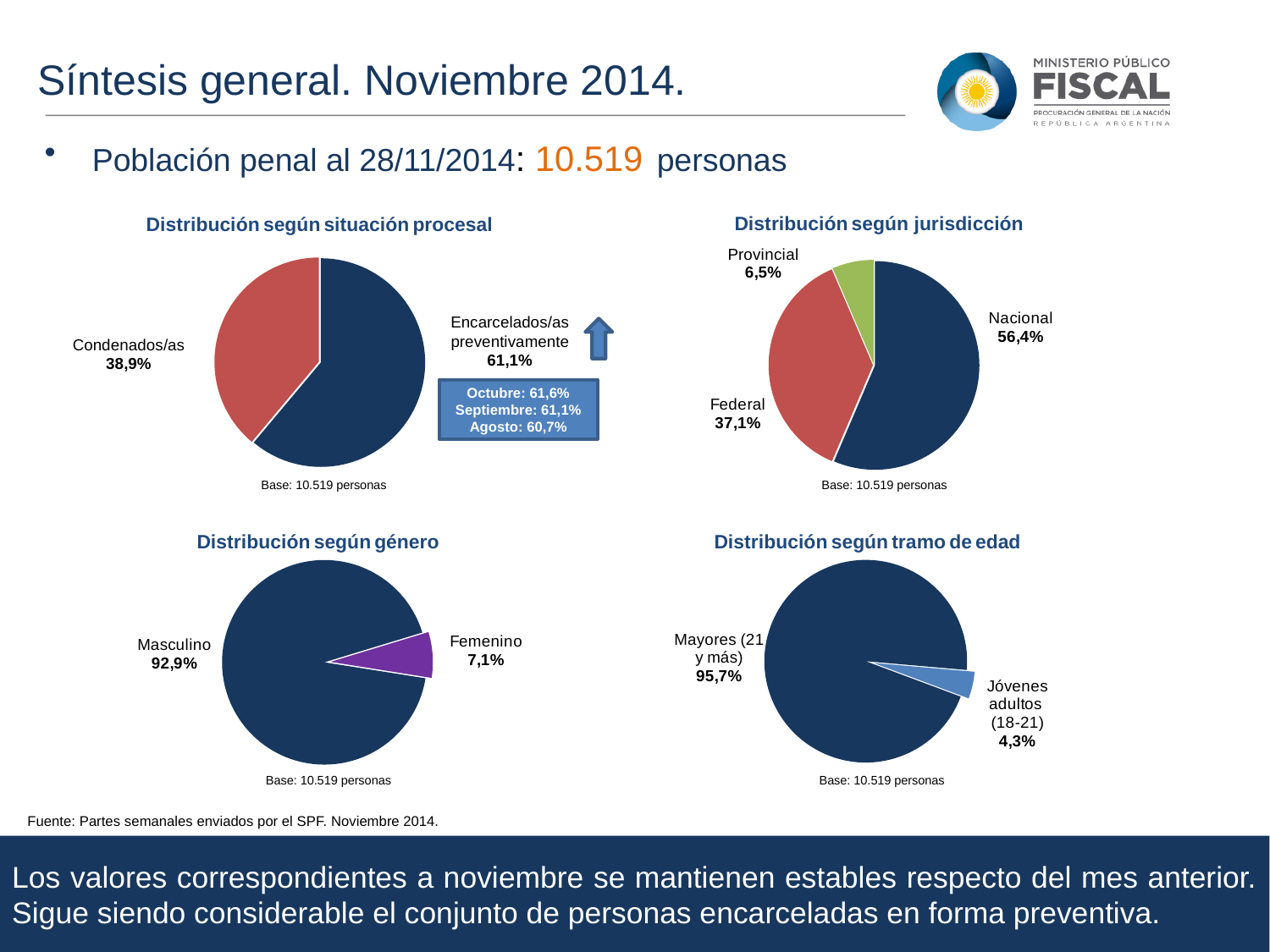
What kind of chart is 'Distribución según tramo de edad'? Pie chart In the 'Distribución según género' chart, which is larger, Masculino or Femenino? Masculino In the 'Distribución según situación procesal' chart, what share is labelled for Condenados/as? 38,9% In the 'Distribución según jurisdicción' chart, what share is labelled for Federal? 37,1% In the 'Distribución según situación procesal' chart, what share is labelled for Encarcelados/as preventivamente? 61,1% In the 'Distribución según situación procesal' chart, what value is given for Octubre in the inset box? 61,6% In the 'Distribución según jurisdicción' chart, which category has the largest slice? Nacional In the 'Distribución según género' chart, what share is labelled for Femenino? 7,1% In the 'Distribución según jurisdicción' chart, which category has the smallest slice? Provincial In the 'Distribución según tramo de edad' chart, what share is labelled for Jóvenes adultos (18-21)? 4,3% In the 'Distribución según jurisdicción' chart, how many categories are shown? 3 In the 'Distribución según jurisdicción' chart, what is the difference between the Nacional and Federal shares? 19,3%